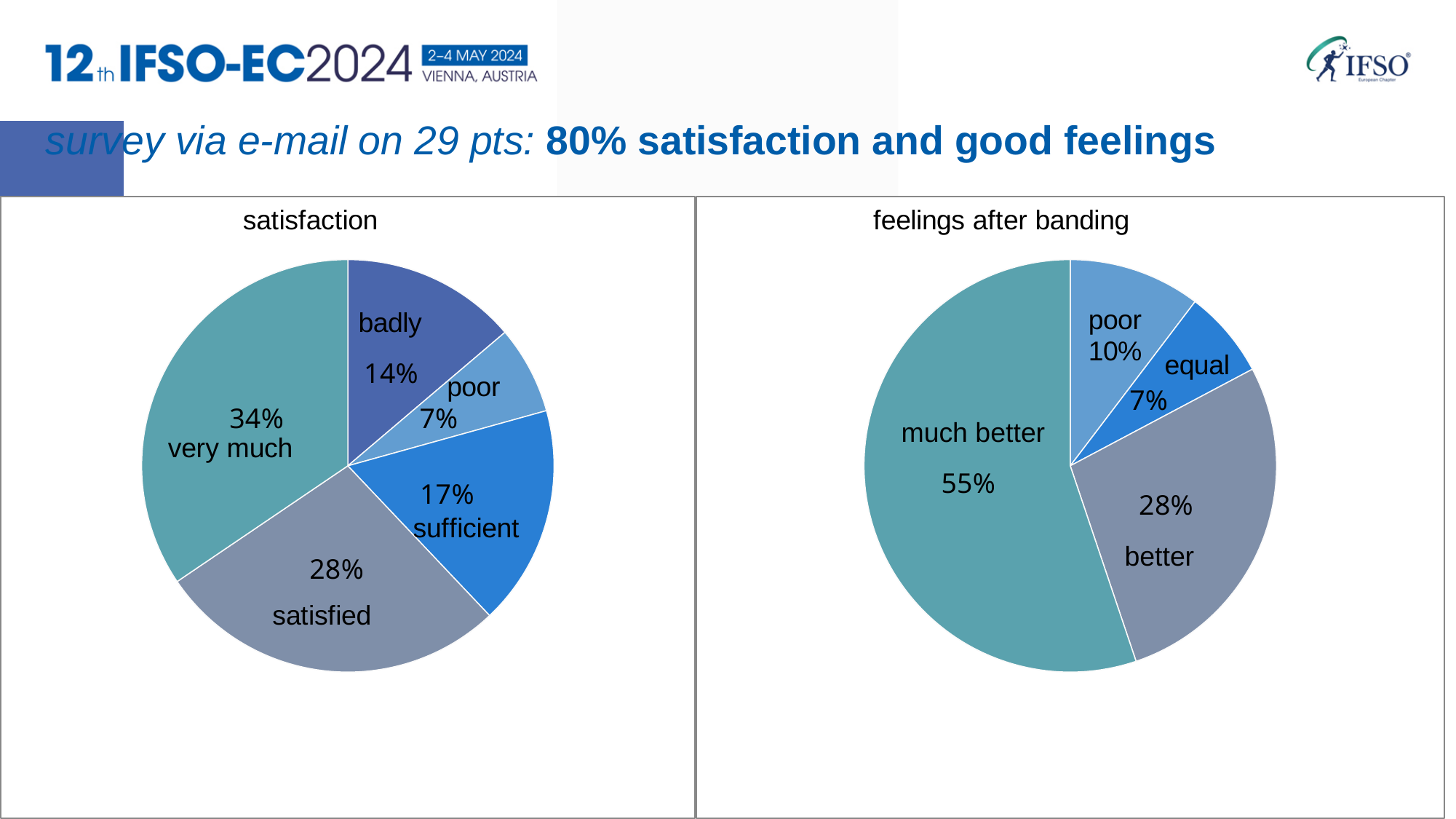
In the 'feelings after banding' chart, which is larger, 'poor' or 'equal'? poor In the 'satisfaction' chart, which category has the smallest slice? poor In the 'feelings after banding' chart, what share is labelled 'equal'? 7% In the 'feelings after banding' chart, which category has the largest slice? much better In the 'satisfaction' chart, how many slices does the pie have? 5 In the 'satisfaction' chart, what is the difference between the 'satisfied' and 'sufficient' shares? 11% In the 'satisfaction' chart, what share is labelled 'very much'? 34% What kind of chart is the 'feelings after banding' chart? pie chart In the 'feelings after banding' chart, how many slices does the pie have? 4 In the 'satisfaction' chart, what share is labelled 'badly'? 14% In the 'satisfaction' chart, which category has the largest slice? very much In the 'feelings after banding' chart, what share is labelled 'much better'? 55%